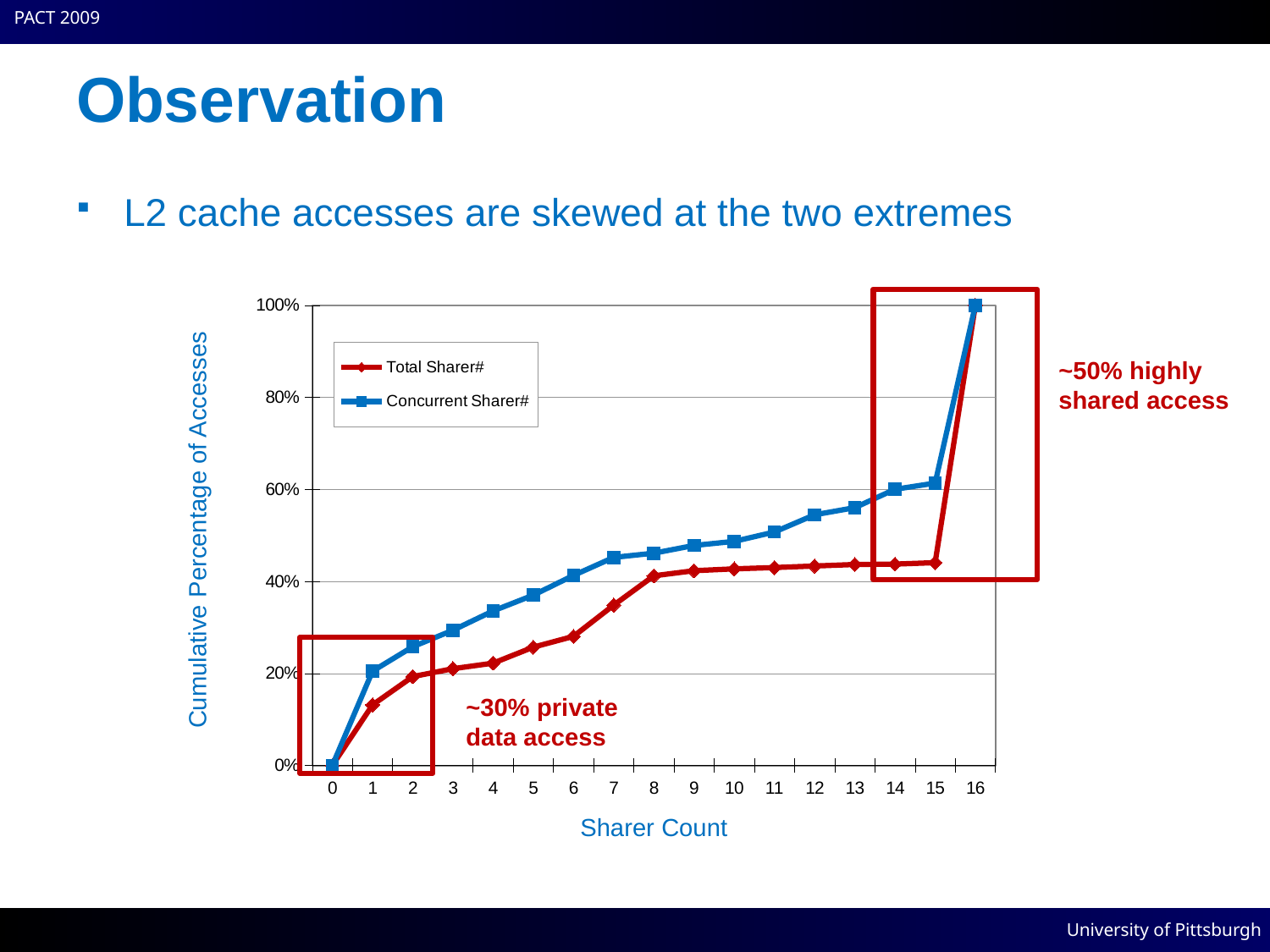
Do the values of Total Sharer# rise or fall as sharer count increases? rise At sharer count 5, which series has the larger value, Total Sharer# or Concurrent Sharer#? Concurrent Sharer# What are the two series named in the legend? Total Sharer# and Concurrent Sharer# How many sharer count values are plotted along the x axis? 17 What is the value of Total Sharer# at sharer count 0? 0% Is the value for Total Sharer# at sharer count 1 greater or less than 20%? less Is the value for Concurrent Sharer# at sharer count 12 greater or less than 60%? less What is the title of the x axis? Sharer Count Is the value for Total Sharer# at sharer count 15 greater or less than 40%? greater What kind of chart is shown on the slide? line chart How many series does the legend list? 2 What is the value of Concurrent Sharer# at sharer count 16? 100%